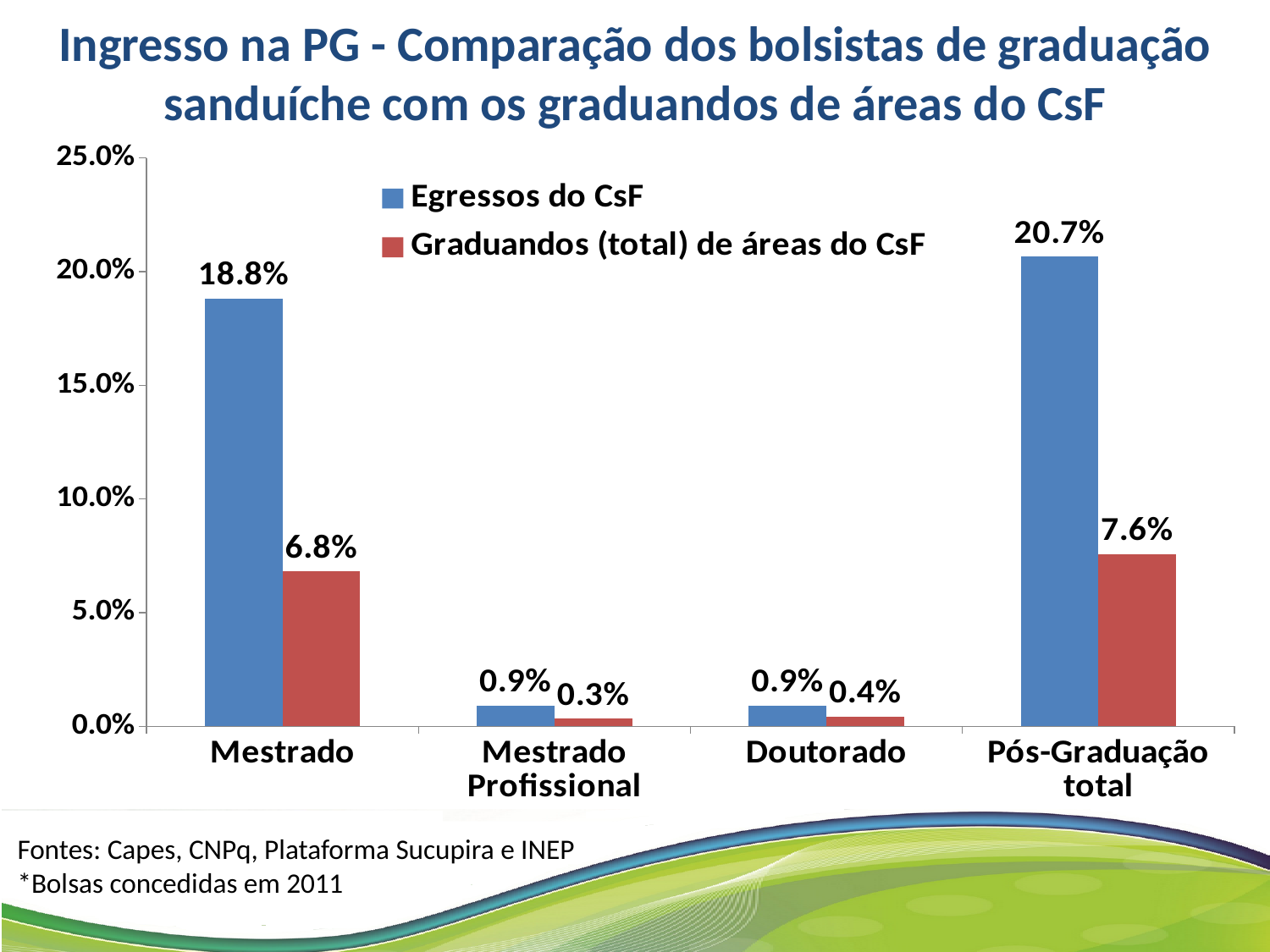
How many series does the legend list? 2 What kind of chart is shown on the slide? Bar chart What is the value for Egressos do CsF in the Mestrado category? 18.8% Which is larger: Egressos do CsF for Mestrado or Egressos do CsF for Pós-Graduação total? Egressos do CsF for Pós-Graduação total What is the difference between Egressos do CsF and Graduandos (total) de áreas do CsF in the Mestrado category? 12.0% Is the value for Egressos do CsF in the Pós-Graduação total category greater or less than 20.0%? greater What is the difference between Egressos do CsF and Graduandos (total) de áreas do CsF in the Pós-Graduação total category? 13.1% Which category has the highest value for Egressos do CsF? Pós-Graduação total How many categories are shown on the x axis? 4 What is the value for Graduandos (total) de áreas do CsF in the Doutorado category? 0.4% What is the value for Graduandos (total) de áreas do CsF in the Pós-Graduação total category? 7.6% Which category has the lowest value for Graduandos (total) de áreas do CsF? Mestrado Profissional